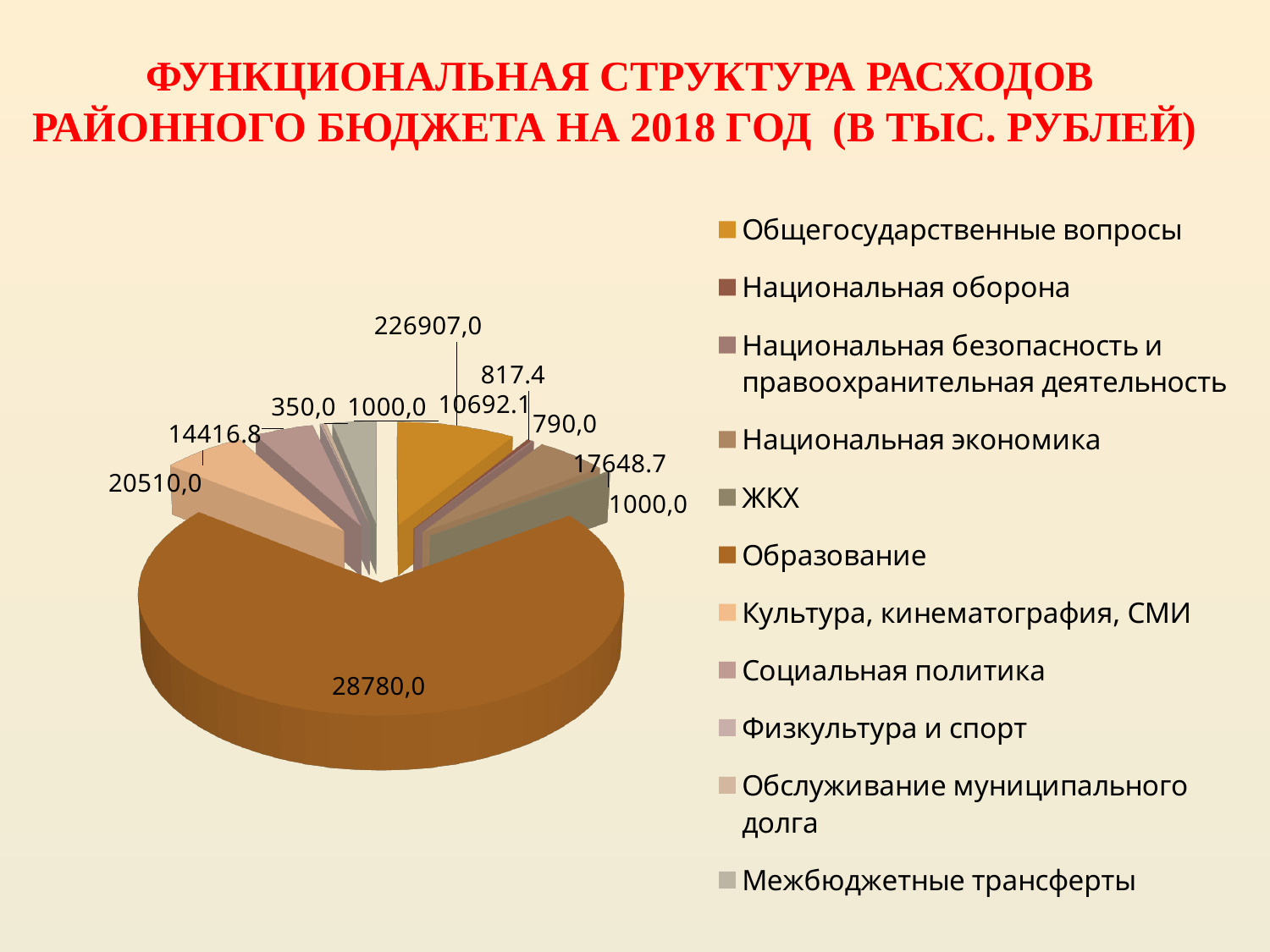
How many data labels are printed on the pie chart? 11 Which category is listed last in the legend of the pie chart? Межбюджетные трансферты What is the smallest value printed on the pie chart? 350,0 Which is larger in the pie chart: Образование or Общегосударственные вопросы? Образование Which category takes the largest share of the pie chart? Образование How many categories does the legend of the pie chart list? 11 What is the title of the chart on the slide? ФУНКЦИОНАЛЬНАЯ СТРУКТУРА РАСХОДОВ РАЙОННОГО БЮДЖЕТА НА 2018 ГОД (В ТЫС. РУБЛЕЙ) What kind of chart is shown on the slide? pie chart What is the largest value printed on the pie chart? 226907,0